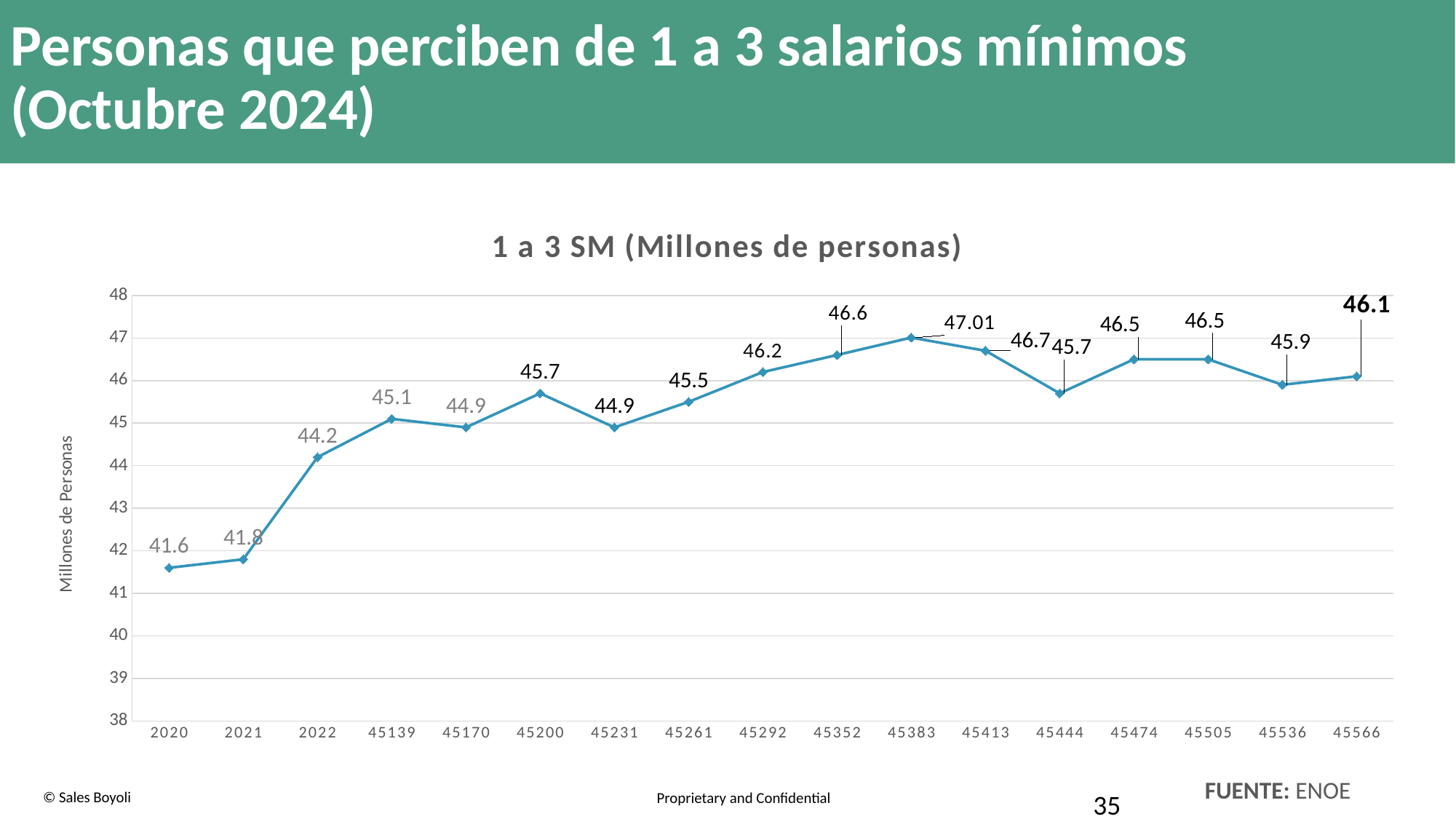
Which category has the lowest value? 2020 Which category has the highest value? 45383 What kind of chart is shown on the slide? line chart What is the value for 45383? 47.01 Which is larger, the value for 45200 or the value for 45231? 45200 What is the value for 2020? 41.6 What is the value for 45566? 46.1 Is the value for 45292 greater or less than 46? greater What is the difference between the values for 2022 and 2021? 2.4 What is the title of the chart? 1 a 3 SM (Millones de personas) What is the value for 2022? 44.2 How many data points are plotted on the chart? 17